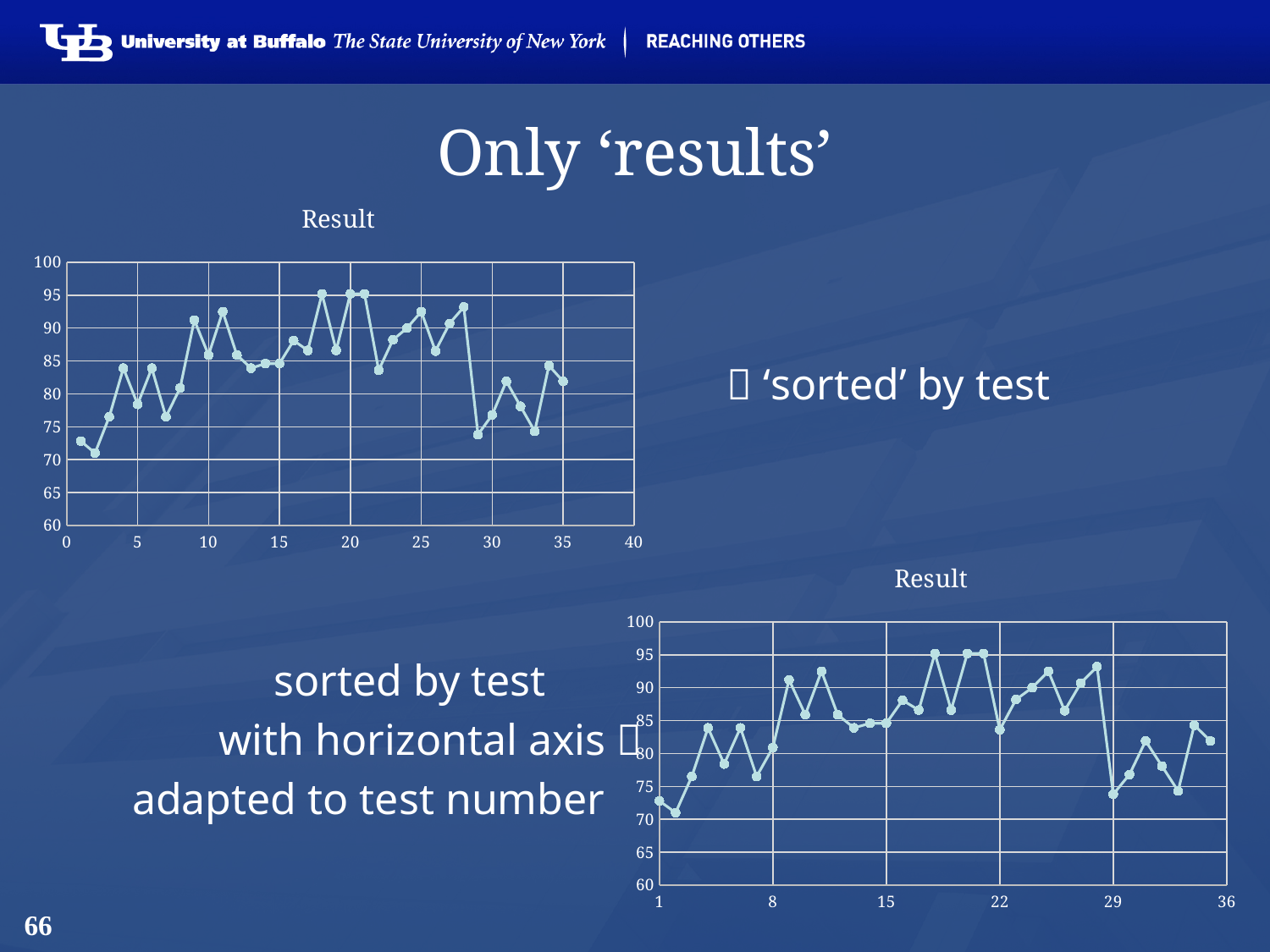
In the top-left chart, is the value at x = 20 greater or less than 90? greater What kind of chart is the bottom-right chart titled 'Result'? line chart In the bottom-right chart, is the value at test 29 greater or less than 80? less What is the title of the bottom-right chart? Result What is the highest tick label on the horizontal axis of the bottom-right chart? 36 In the top-left chart, which is larger, the value at x = 2 or the value at x = 20? x = 20 What kind of chart is the top-left chart titled 'Result'? line chart In the top-left chart, is the value at x = 2 greater or less than 75? less In the top-left chart, which is larger, the value at x = 28 or the value at x = 29? x = 28 In the top-left chart, do the values generally rise or fall from x = 1 to x = 9? rise